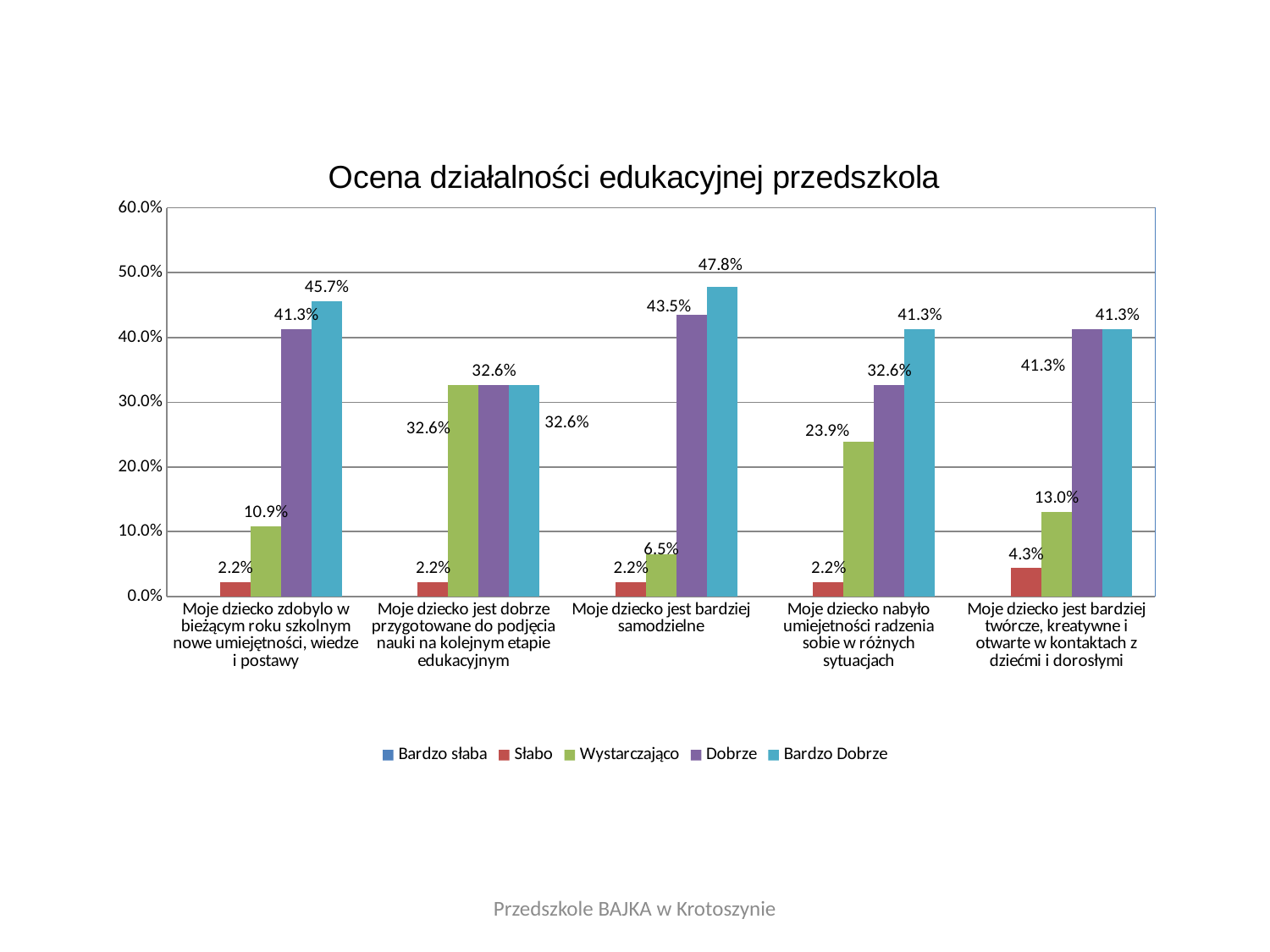
What is the value of 'Wystarczająco' for 'Moje dziecko nabyło umiejetności radzenia sobie w różnych sytuacjach'? 23.9% Which is larger for 'Moje dziecko nabyło umiejetności radzenia sobie w różnych sytuacjach': 'Dobrze' or 'Bardzo Dobrze'? Bardzo Dobrze How many categories are shown on the x axis? 5 What is the value of 'Bardzo Dobrze' for 'Moje dziecko jest bardziej samodzielne'? 47.8% Is the 'Wystarczająco' value for 'Moje dziecko jest dobrze przygotowane do podjęcia nauki na kolejnym etapie edukacyjnym' greater or less than 30.0%? greater Which category has the lowest 'Wystarczająco' value? Moje dziecko jest bardziej samodzielne What is the title of the chart? Ocena działalności edukacyjnej przedszkola What is the value of 'Słabo' for 'Moje dziecko jest bardziej twórcze, kreatywne i otwarte w kontaktach z dziećmi i dorosłymi'? 4.3% What is the difference between the 'Bardzo Dobrze' and 'Dobrze' values for 'Moje dziecko zdobylo w bieżącym roku szkolnym nowe umiejętności, wiedze i postawy'? 4.4% Which category has the highest 'Bardzo Dobrze' value? Moje dziecko jest bardziej samodzielne How many series does the legend list? 5 What type of chart is shown on the slide? bar chart